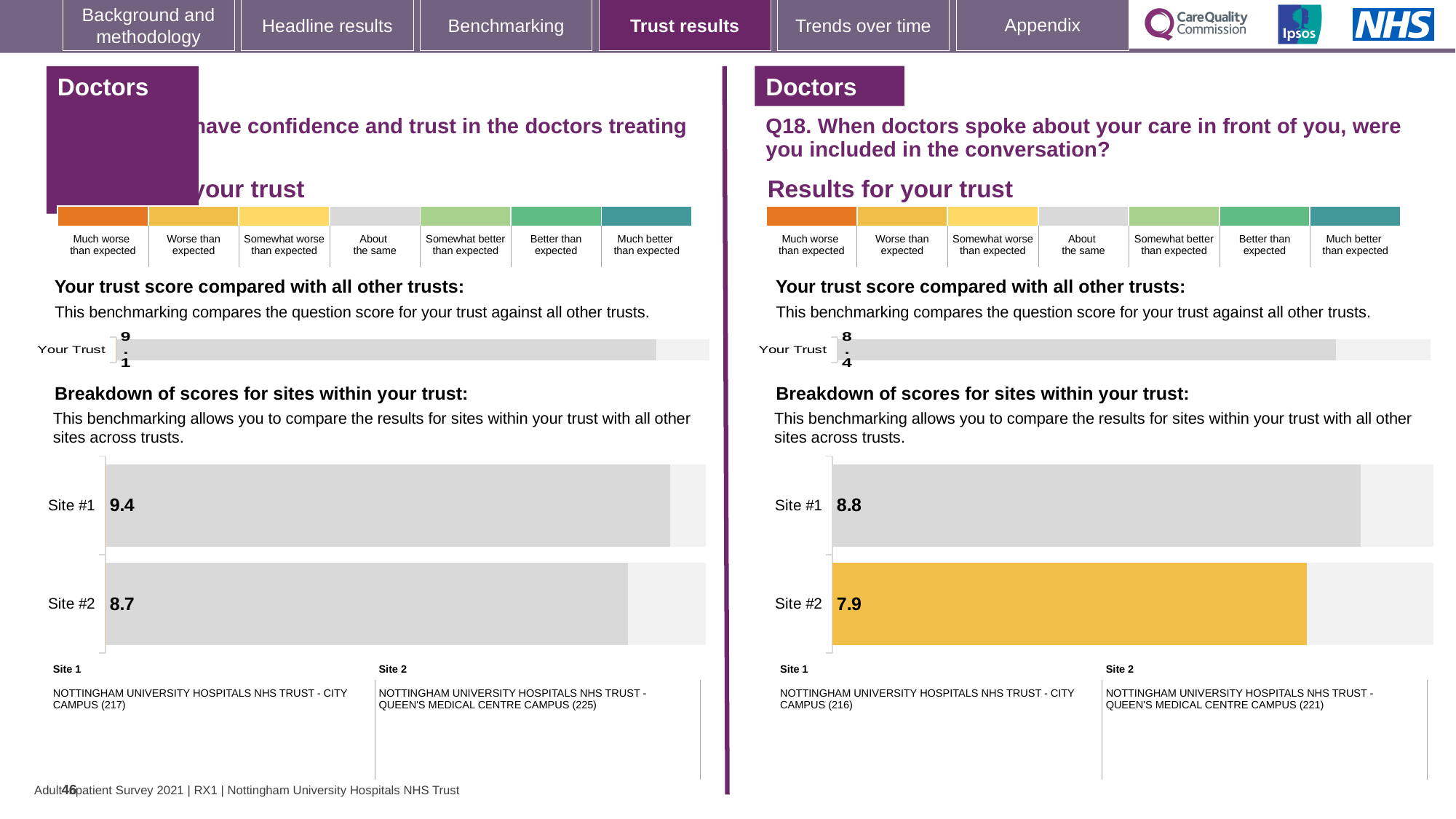
On the Q18 site breakdown chart, which site has the lowest score? Site #2 On the left-hand site breakdown chart, what is the difference between the scores for Site #1 and Site #2? 0.7 On the Q18 'Breakdown of scores for sites within your trust' chart, what is the score for Site #2? 7.9 How many sites are shown on the Q18 site breakdown chart? 2 On the Q18 site breakdown chart, what is the difference between the scores for Site #1 and Site #2? 0.9 On the left-hand 'Breakdown of scores for sites within your trust' chart, what is the score for Site #2? 8.7 On the Q18 'Breakdown of scores for sites within your trust' chart, what is the score for Site #1? 8.8 On the left-hand 'Your trust score compared with all other trusts' chart, what is the score for Your Trust? 9.1 On the left-hand site breakdown chart, which site has the highest score? Site #1 What type of chart is used for the Q18 site breakdown? Bar chart On the Q18 'Your trust score compared with all other trusts' chart, what is the score for Your Trust? 8.4 On the left-hand 'Breakdown of scores for sites within your trust' chart, what is the score for Site #1? 9.4